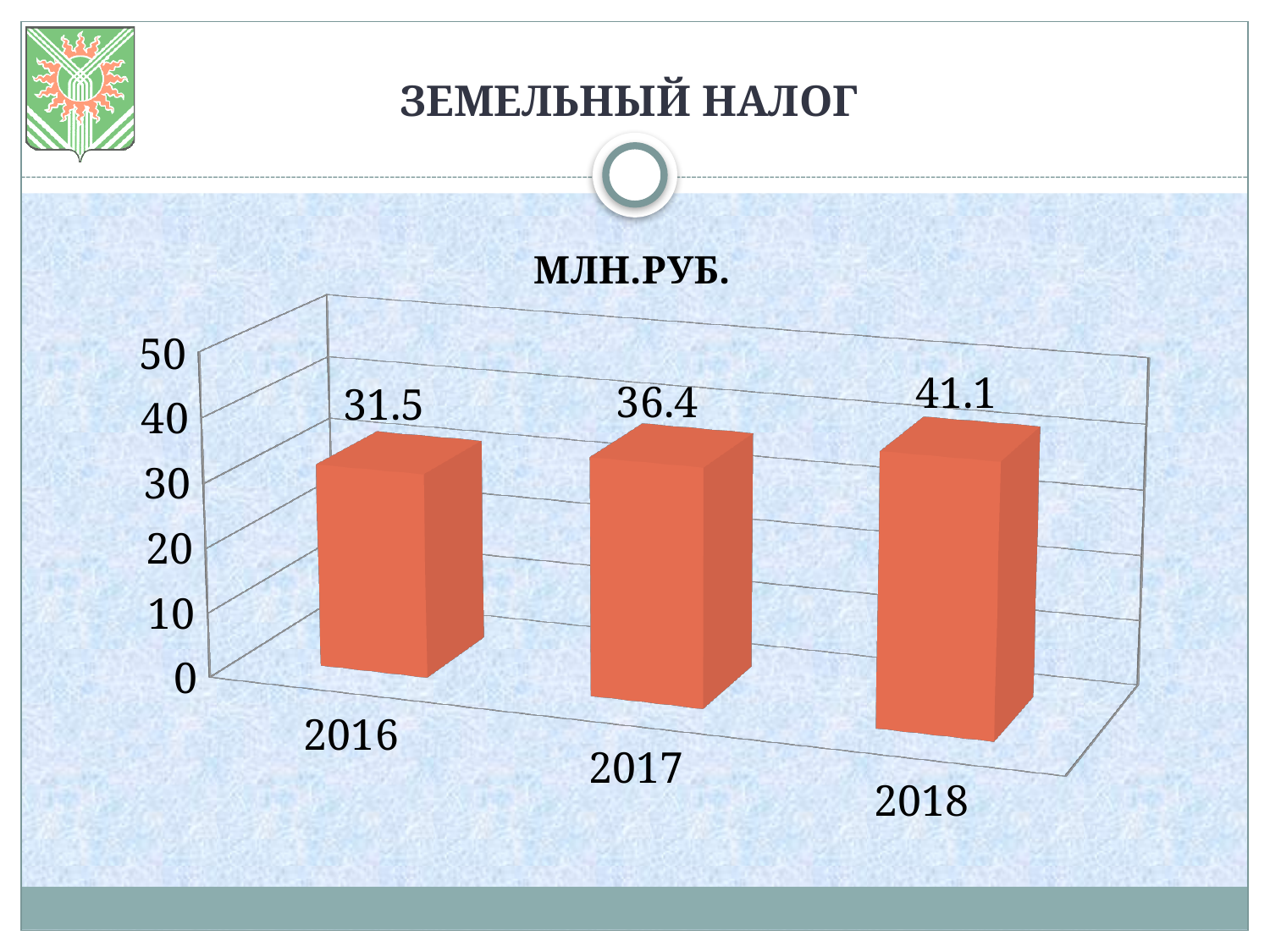
What kind of chart is shown on the slide? bar chart What is the value for 2018? 41.1 Do the values rise or fall from 2016 to 2018? rise Is the value for 2018 greater or less than 40? greater What is the value for 2017? 36.4 Which year has the highest value? 2018 How many years are shown on the chart? 3 What is the value for 2016? 31.5 Which is larger, the value for 2017 or the value for 2018? 2018 What is the difference between the values for 2017 and 2016? 4.9 What is the difference between the values for 2018 and 2016? 9.6 Which year has the lowest value? 2016